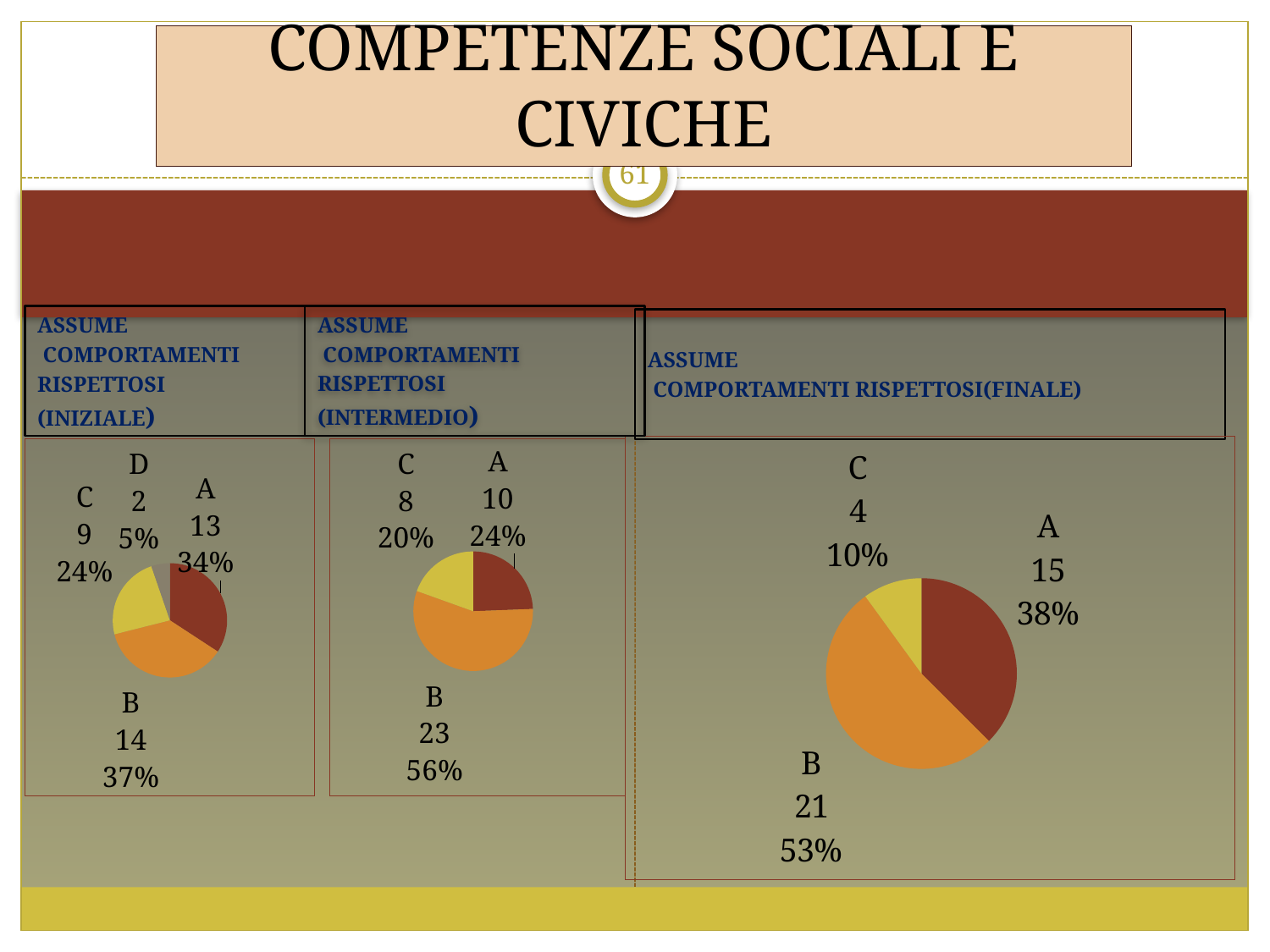
In the INIZIALE pie chart, which category has the lowest value? D In the INIZIALE pie chart, how many categories are shown? 4 In the INTERMEDIO pie chart, what share of the pie does category C have? 20% In the INIZIALE pie chart, what value is shown for category B? 14 In the FINALE pie chart, what value is shown for category A? 15 In the FINALE pie chart, what share of the pie does category B have? 53% In the INIZIALE pie chart, what share of the pie does category D have? 5% In the INTERMEDIO pie chart, what is the difference between the values for B and A? 13 What kind of chart is used in the FINALE panel? Pie chart In the FINALE pie chart, which is larger, the value for A or the value for C? A In the INTERMEDIO pie chart, which category has the highest value? B In the INTERMEDIO pie chart, what value is shown for category B? 23